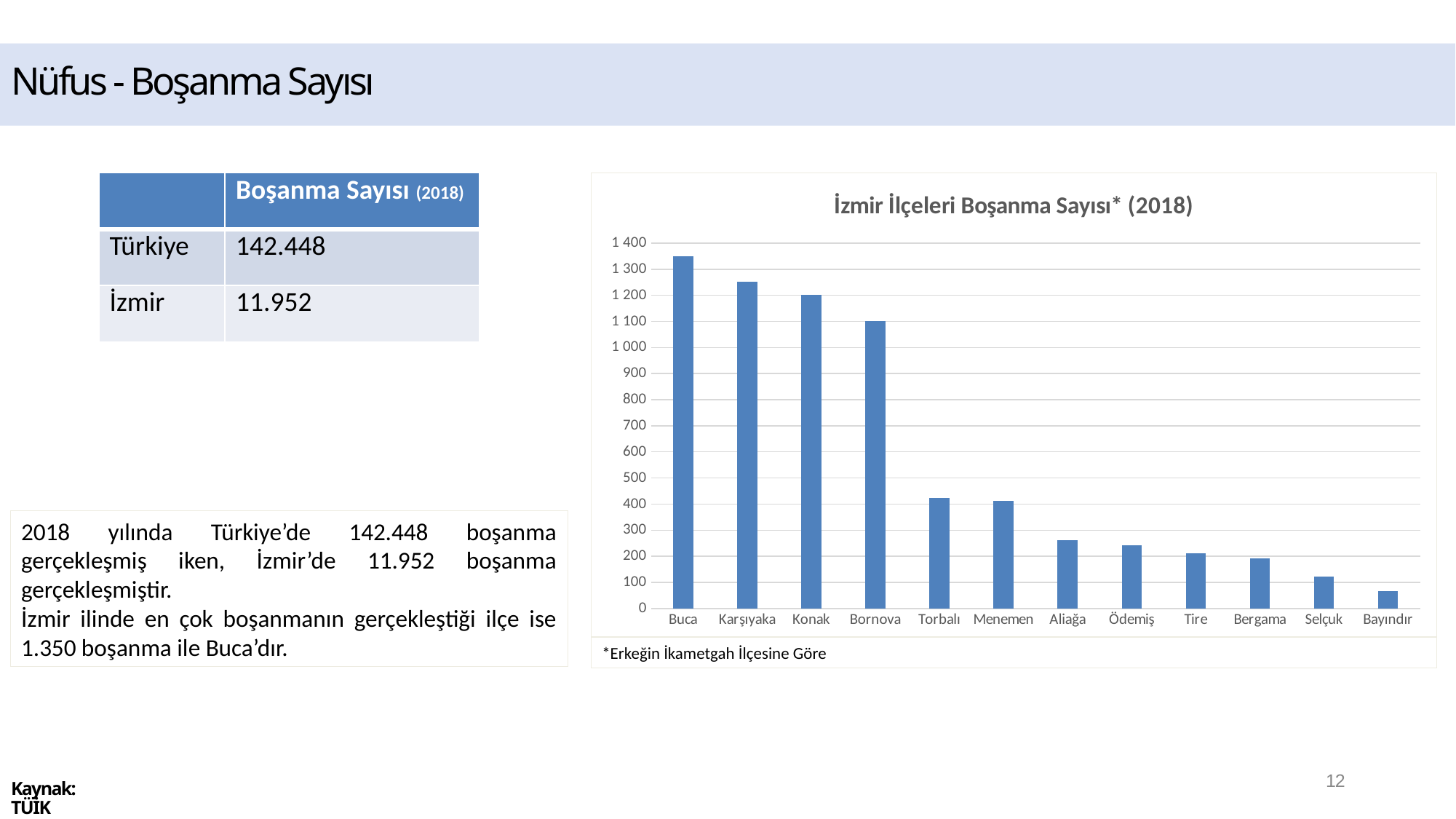
Is the value for Aliağa greater or less than 300? less What is the title of the chart? İzmir İlçeleri Boşanma Sayısı* (2018) How many districts (categories) are shown in the chart? 12 Is the value for Karşıyaka greater or less than 1 200? greater Is the value for Torbalı greater or less than 500? less What is the number of divorces for Buca in 2018? 1.350 Which has more divorces, Buca or Karşıyaka? Buca Which district has the lowest number of divorces in the chart? Bayındır Which district has the highest number of divorces in the chart? Buca Do the values rise or fall from left to right along the x axis? fall What type of chart is shown on the slide? bar chart